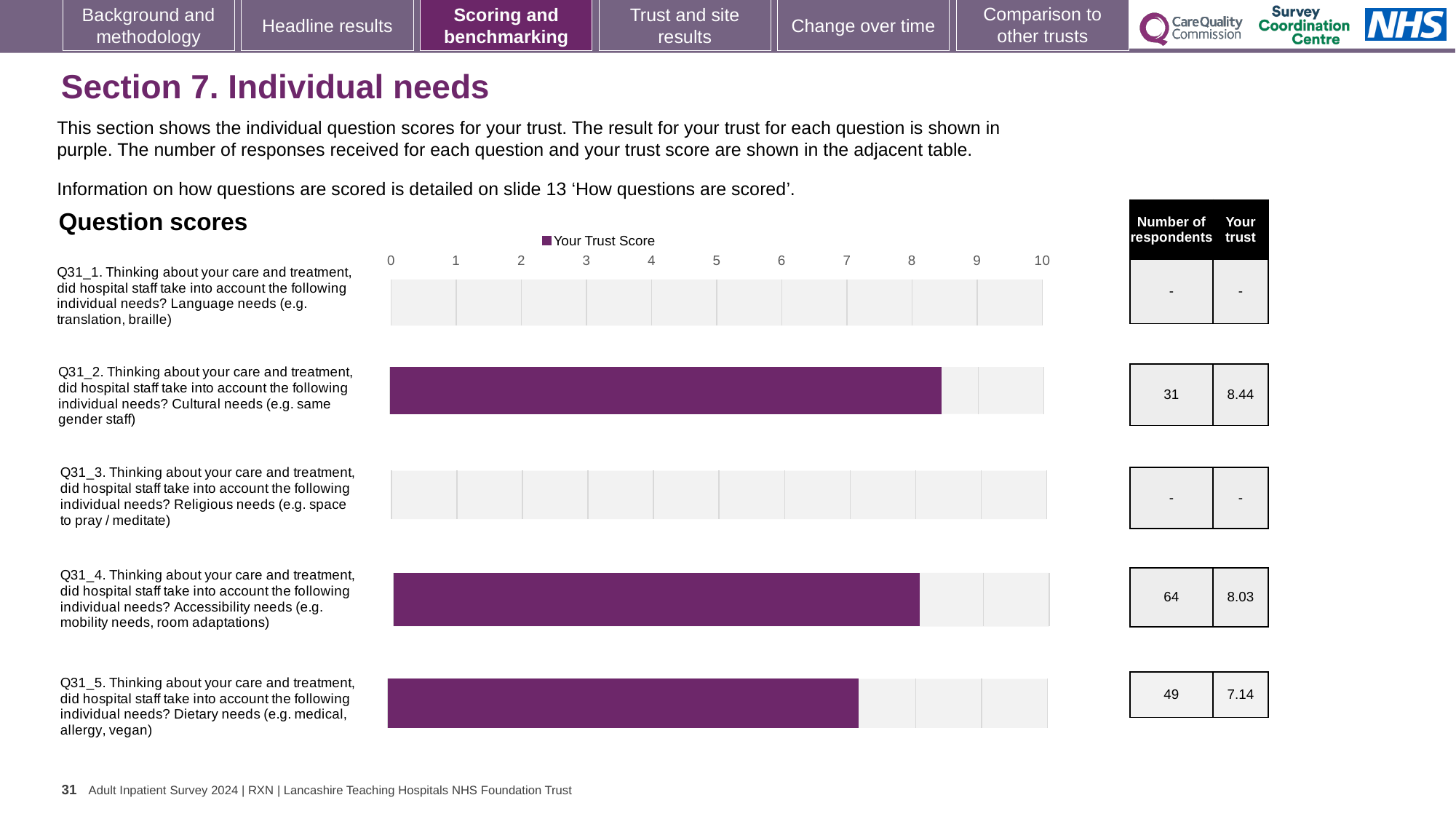
What is the trust score for Q31_2 (Cultural needs)? 8.44 What type of chart is used to show the question scores? Bar chart Which has a higher trust score, Q31_4 (Accessibility needs) or Q31_5 (Dietary needs)? Q31_4 (Accessibility needs) What is the difference between the trust scores for Q31_2 and Q31_5? 1.30 How many respondents answered Q31_4 (Accessibility needs)? 64 Among the questions with a plotted bar, which has the lowest trust score? Q31_5 (Dietary needs) What is the trust score for Q31_4 (Accessibility needs)? 8.03 Which question has the highest trust score on the chart? Q31_2 (Cultural needs) How many questions are listed on the chart? 5 What series does the chart legend show? Your Trust Score Is the trust score for Q31_5 (Dietary needs) greater or less than 8? less What is the trust score for Q31_5 (Dietary needs)? 7.14